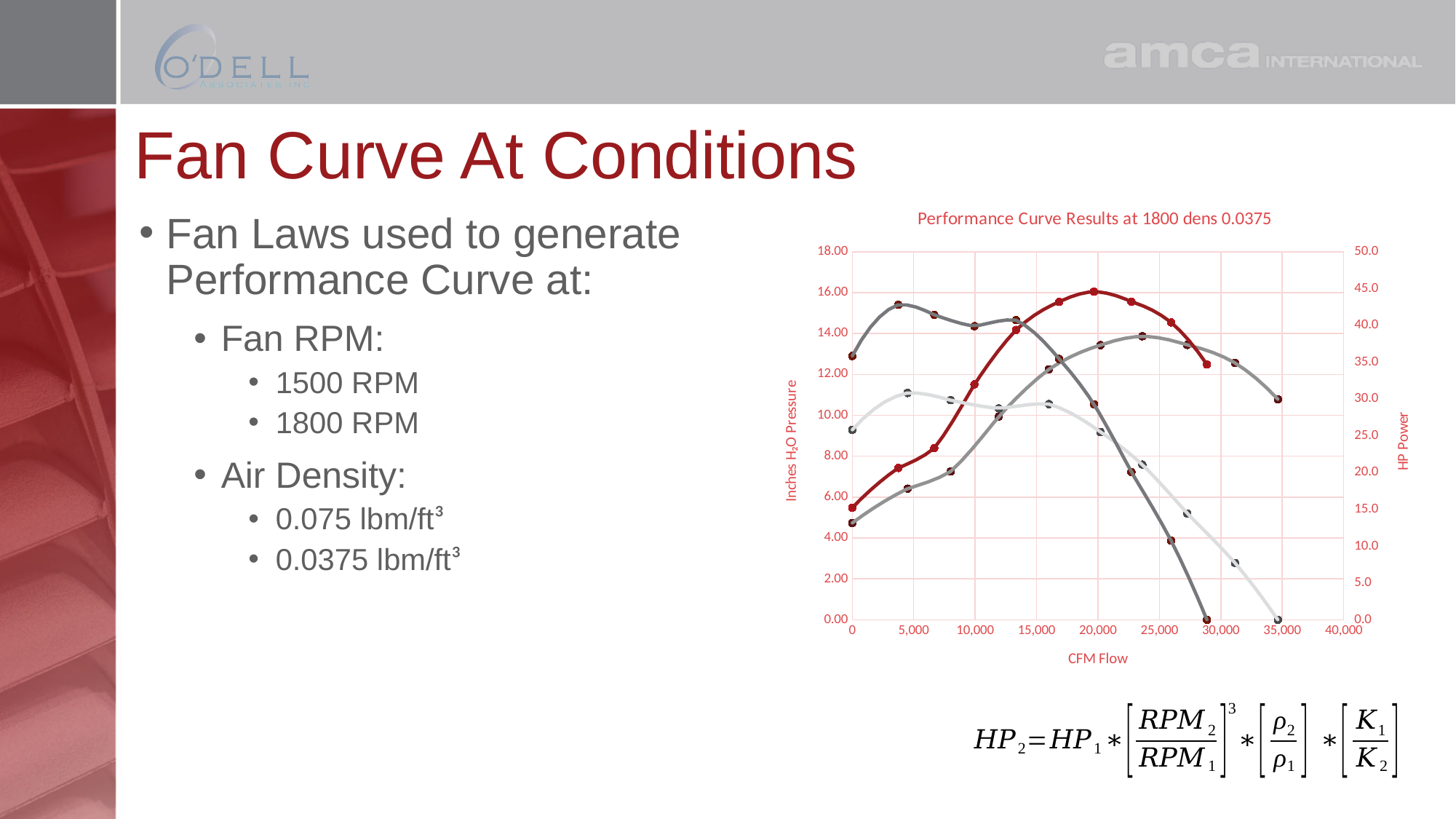
Is the red line's peak, read against the left axis, greater or less than 14.00? greater What is the highest value shown on the left vertical axis of the chart? 18.00 Is the light grey line's peak, read against the left axis, greater or less than 14.00? less How many lines are plotted on the chart? 4 What kind of chart is shown on the slide? Line chart Does the red line rise or fall as CFM Flow increases from 20,000 to 30,000? Fall Does the red line rise or fall as CFM Flow increases from 0 to 20,000? Rise What is the largest CFM Flow value shown on the x axis of the chart? 40,000 What is the title of the chart? Performance Curve Results at 1800 dens 0.0375 What is the highest value shown on the right vertical axis (HP Power) of the chart? 50.0 What is the label of the x axis of the chart? CFM Flow Does the light grey line rise or fall as CFM Flow increases from 20,000 to 35,000? Fall